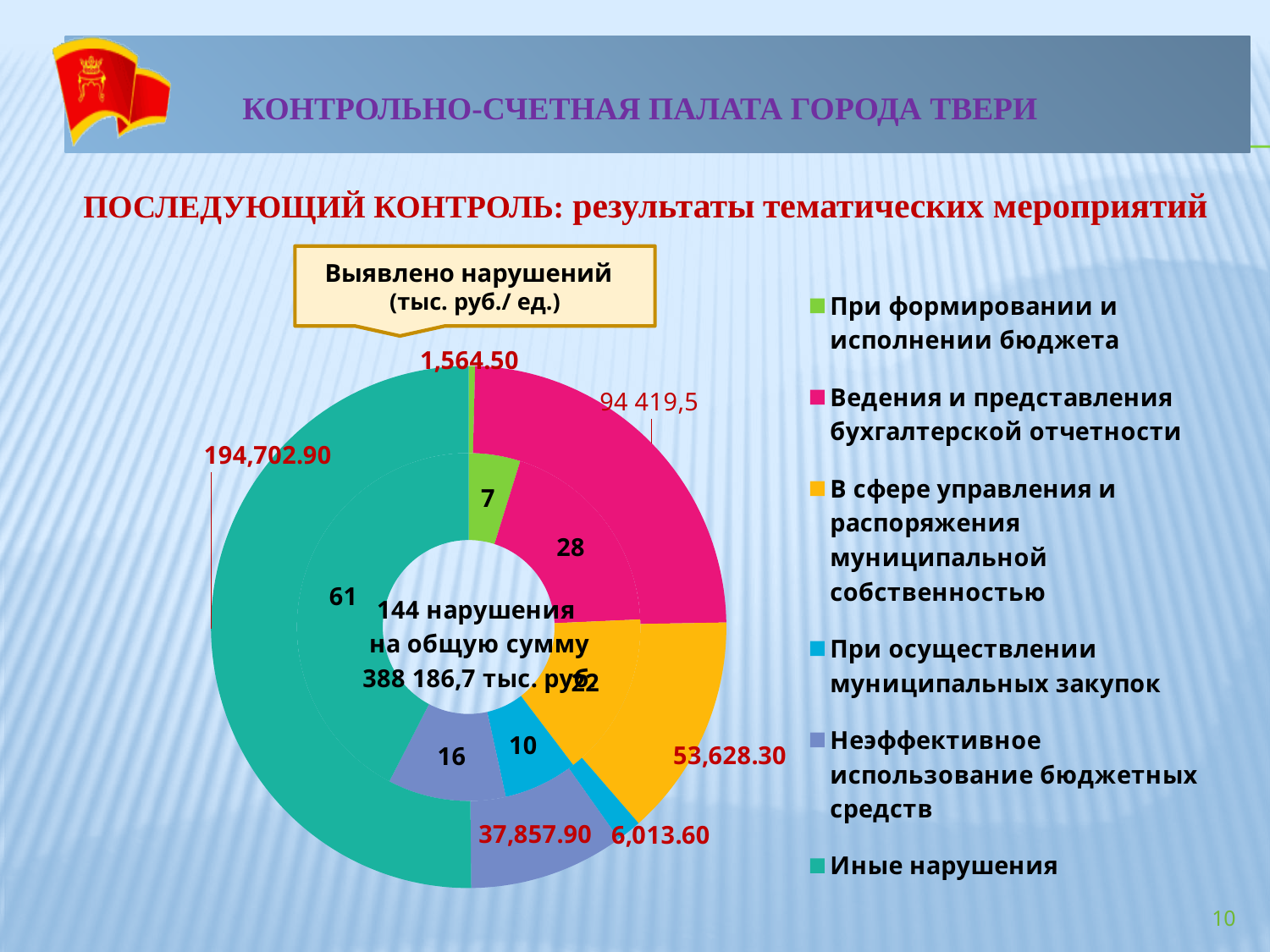
How many categories does the legend of the chart list? 6 What is the number of violations (inner ring) for 'Неэффективное использование бюджетных средств'? 16 What is the difference between the number of violations for 'Иные нарушения' and 'Ведения и представления бухгалтерской отчетности' in the inner ring? 33 What is the number of violations (inner ring) for 'Ведения и представления бухгалтерской отчетности'? 28 What is the difference between the amounts for 'Иные нарушения' and 'В сфере управления и распоряжения муниципальной собственностью'? 141,074.60 What is the total number of violations shown in the centre of the chart? 144 Which has the larger amount: 'Неэффективное использование бюджетных средств' or 'При осуществлении муниципальных закупок'? Неэффективное использование бюджетных средств Which category has the smallest amount in the outer ring? При формировании и исполнении бюджета What kind of chart is shown on the slide? Doughnut chart What is the title shown above the chart? Выявлено нарушений (тыс. руб./ ед.) What is the amount (outer ring) for 'Иные нарушения'? 194,702.90 Which category has the largest amount in the outer ring? Иные нарушения